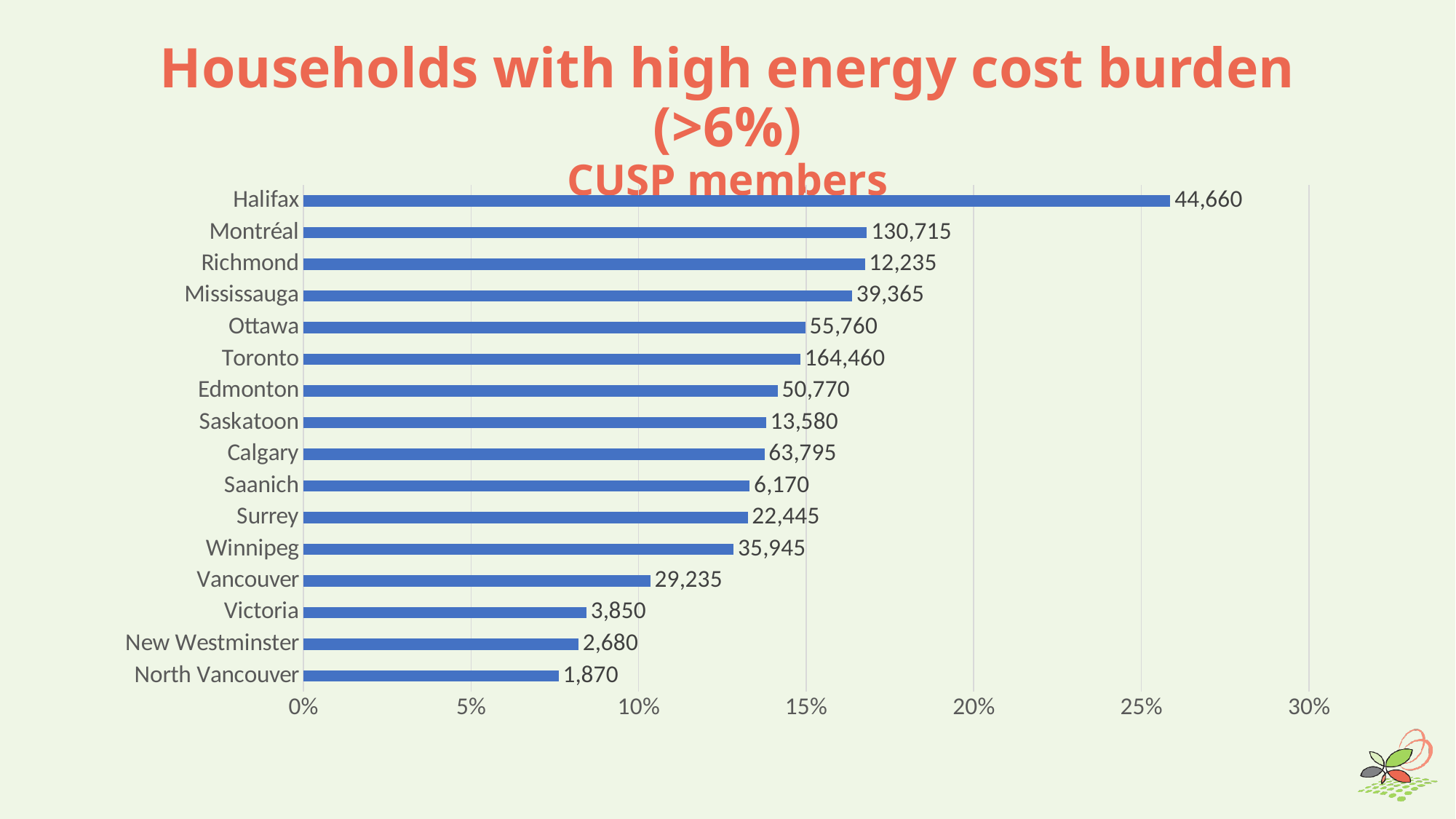
What is the data label shown next to the bar for Halifax? 44,660 Which bar is longer, Halifax or Montréal? Halifax What kind of chart is shown on the slide? bar chart Is the bar for Victoria greater or less than 10%? less Which city has the longest bar in the chart? Halifax Which city has the shortest bar in the chart? North Vancouver What is the data label shown next to the bar for North Vancouver? 1,870 What is the difference between the data labels for Toronto and Montréal? 33,745 Is the bar for Halifax greater or less than 25%? greater What is the data label shown next to the bar for Toronto? 164,460 What is the subtitle shown below the main chart title? CUSP members How many cities are shown in the chart? 16